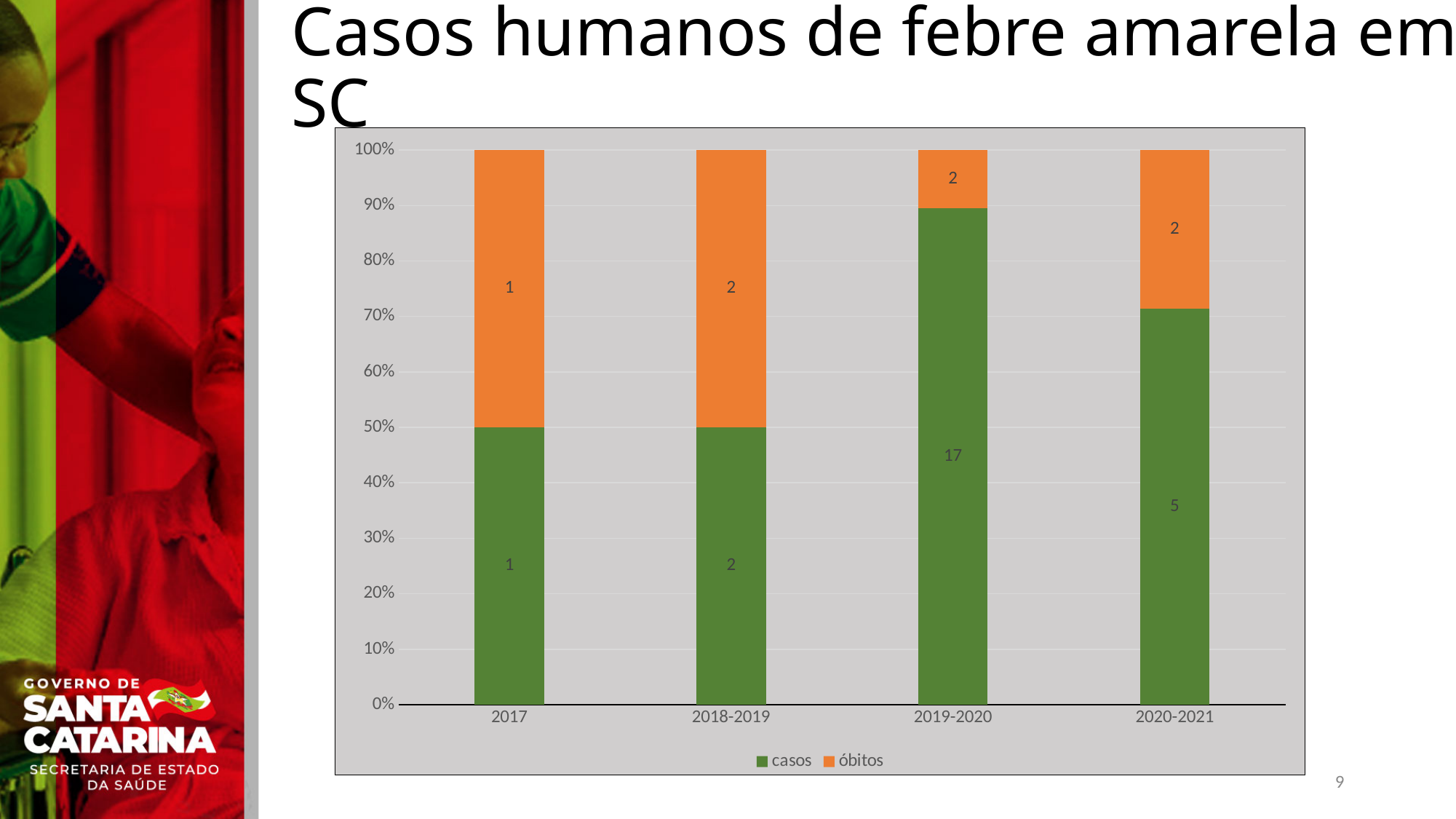
Which period has the highest value for casos? 2019-2020 What is the total of casos and óbitos for 2019-2020? 19 What is the value for casos in 2019-2020? 17 Which is larger: casos in 2018-2019 or casos in 2020-2021? casos in 2020-2021 What kind of chart is shown on the slide? Stacked bar chart What is the difference between casos in 2019-2020 and casos in 2020-2021? 12 What is the value for óbitos in 2020-2021? 2 What is the value for óbitos in 2017? 1 How many periods are shown on the x axis? 4 What is the value for casos in 2020-2021? 5 How many series does the legend list? 2 Which period has the lowest value for casos? 2017